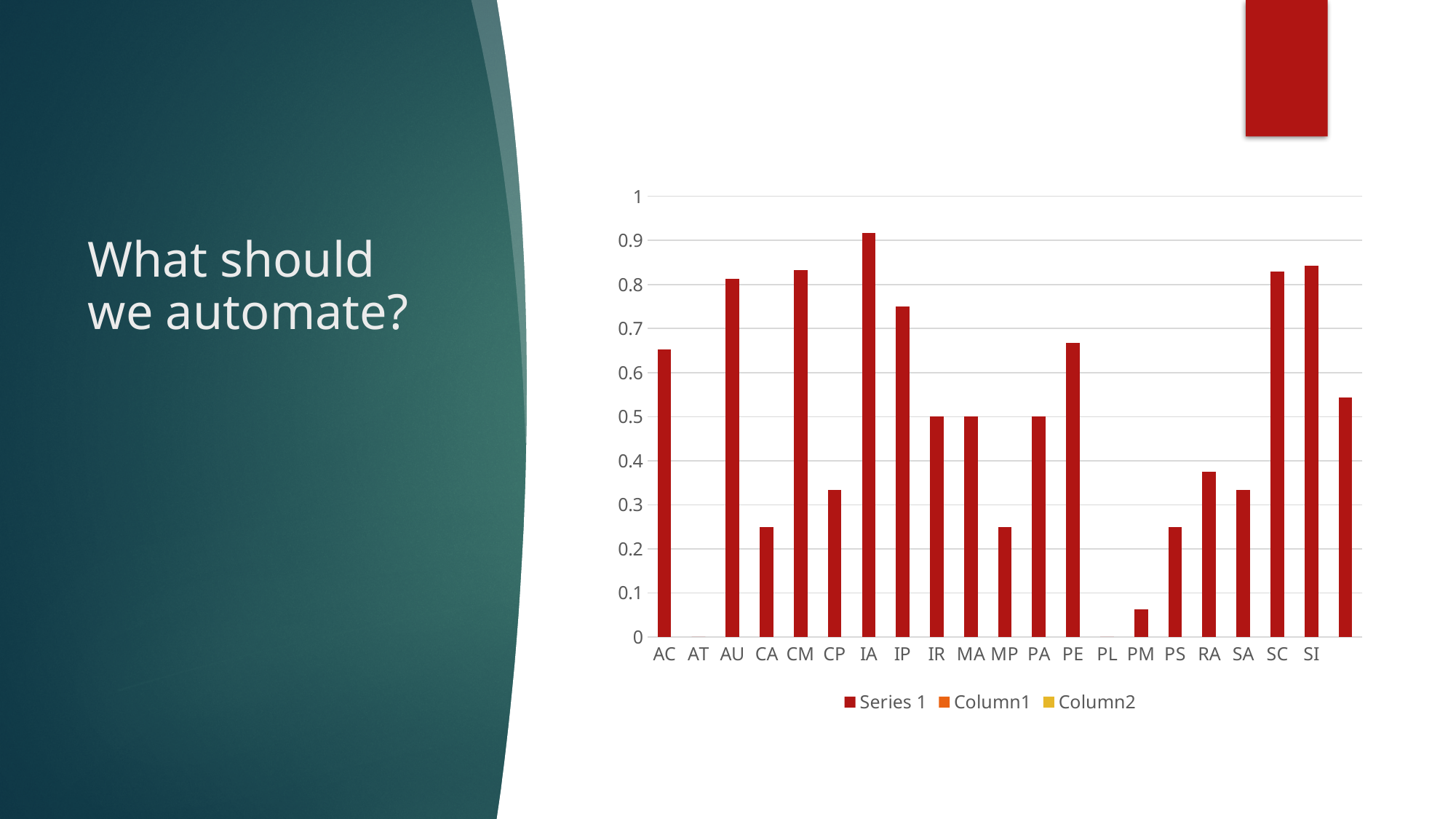
Which category has the highest bar in the chart? IA Is the value for CA greater or less than 0.3? less How many series does the chart's legend list? 3 What is the first entry listed in the chart's legend? Series 1 Which has the larger value, IA or SI? IA Is the value for AC greater or less than 0.6? greater Is the value for IP greater or less than 0.7? greater Which has the larger value, CA or RA? RA How many categories are shown along the x axis of the chart? 20 What kind of chart is shown on the slide? bar chart